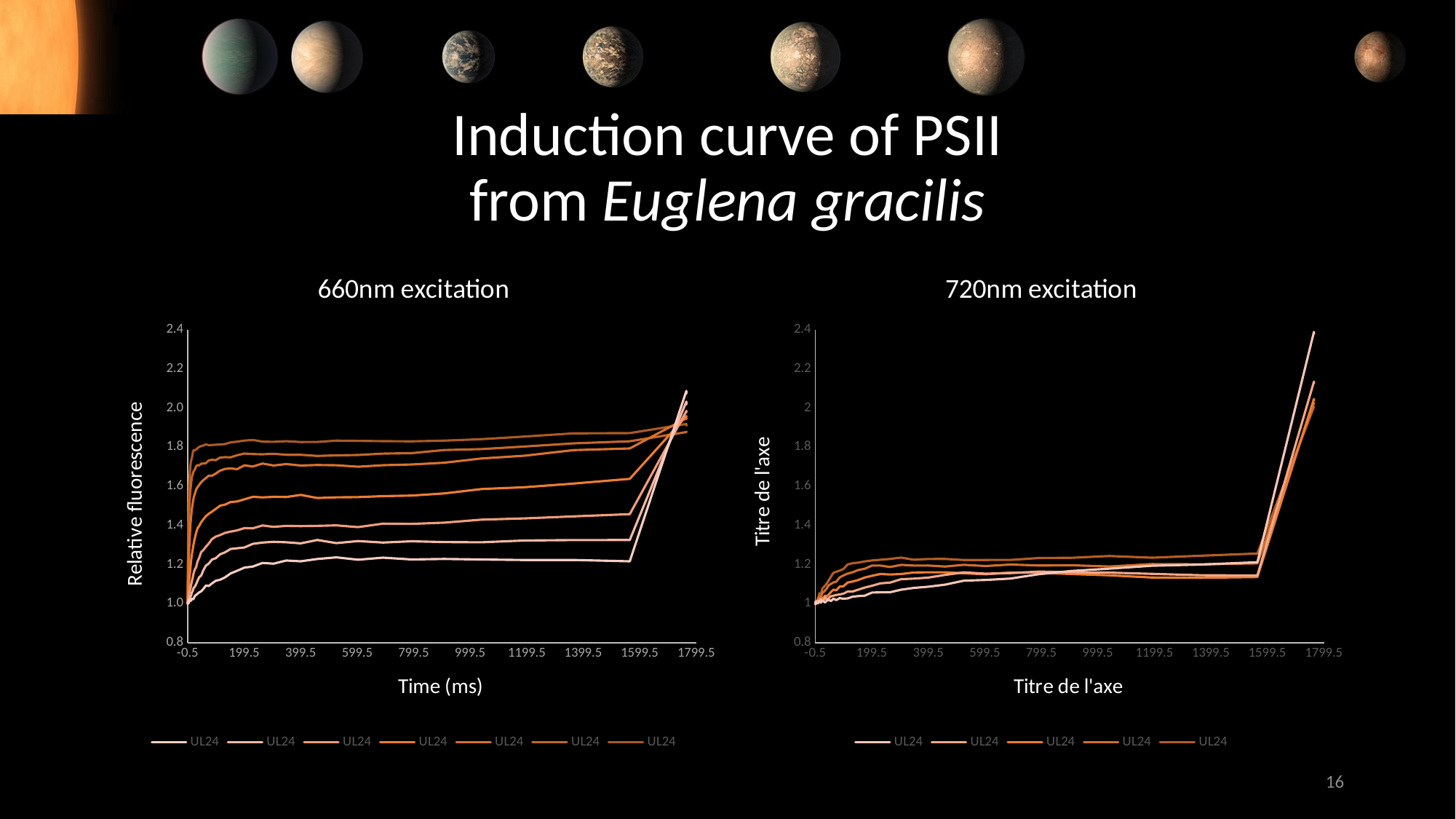
In the 660nm excitation chart, is the topmost line's value at 799.5 greater or less than 1.6? greater What is the x-axis title of the 660nm excitation chart? Time (ms) In the 660nm excitation chart, is the lowest line's value at 999.5 greater or less than 1.4? less What is the maximum value shown on the y axis of the 720nm excitation chart? 2.4 What kind of chart is the 660nm excitation chart? line chart What is the y-axis title of the 660nm excitation chart? Relative fluorescence How many series does the legend of the 660nm excitation chart list? 7 What kind of chart is the 720nm excitation chart? line chart In the 720nm excitation chart, do the lines rise or fall sharply after 1599.5 on the x axis? rise How many series does the legend of the 720nm excitation chart list? 5 In the 720nm excitation chart, is the highest value reached at the right end of the x axis greater or less than 2.2? greater